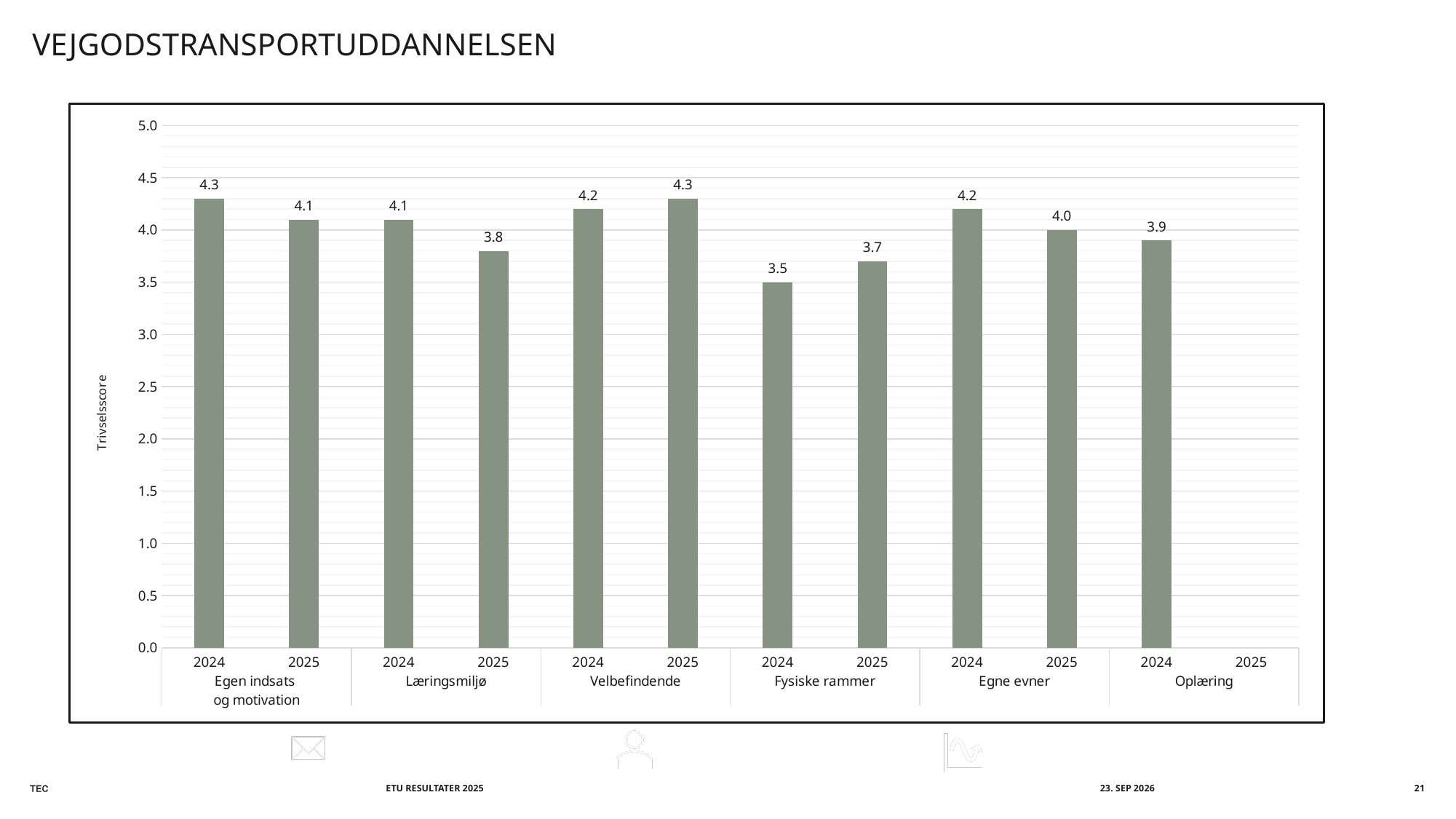
What kind of chart is shown on the slide? bar chart Which bar has the lowest value on the chart? Fysiske rammer 2024 What is the difference between the 2024 and 2025 values for Læringsmiljø? 0.3 What is the value for Læringsmiljø in 2025? 3.8 What is the value for Oplæring in 2024? 3.9 How many themes are shown along the x axis? 6 What is the value for Egen indsats og motivation in 2024? 4.3 What is the difference between the 2024 and 2025 values for Egne evner? 0.2 What is the label on the y axis? Trivselsscore Is the value for Fysiske rammer in 2024 greater or less than 4.0? less Which is larger for Velbefindende: the 2024 value or the 2025 value? 2025 What is the value for Fysiske rammer in 2025? 3.7